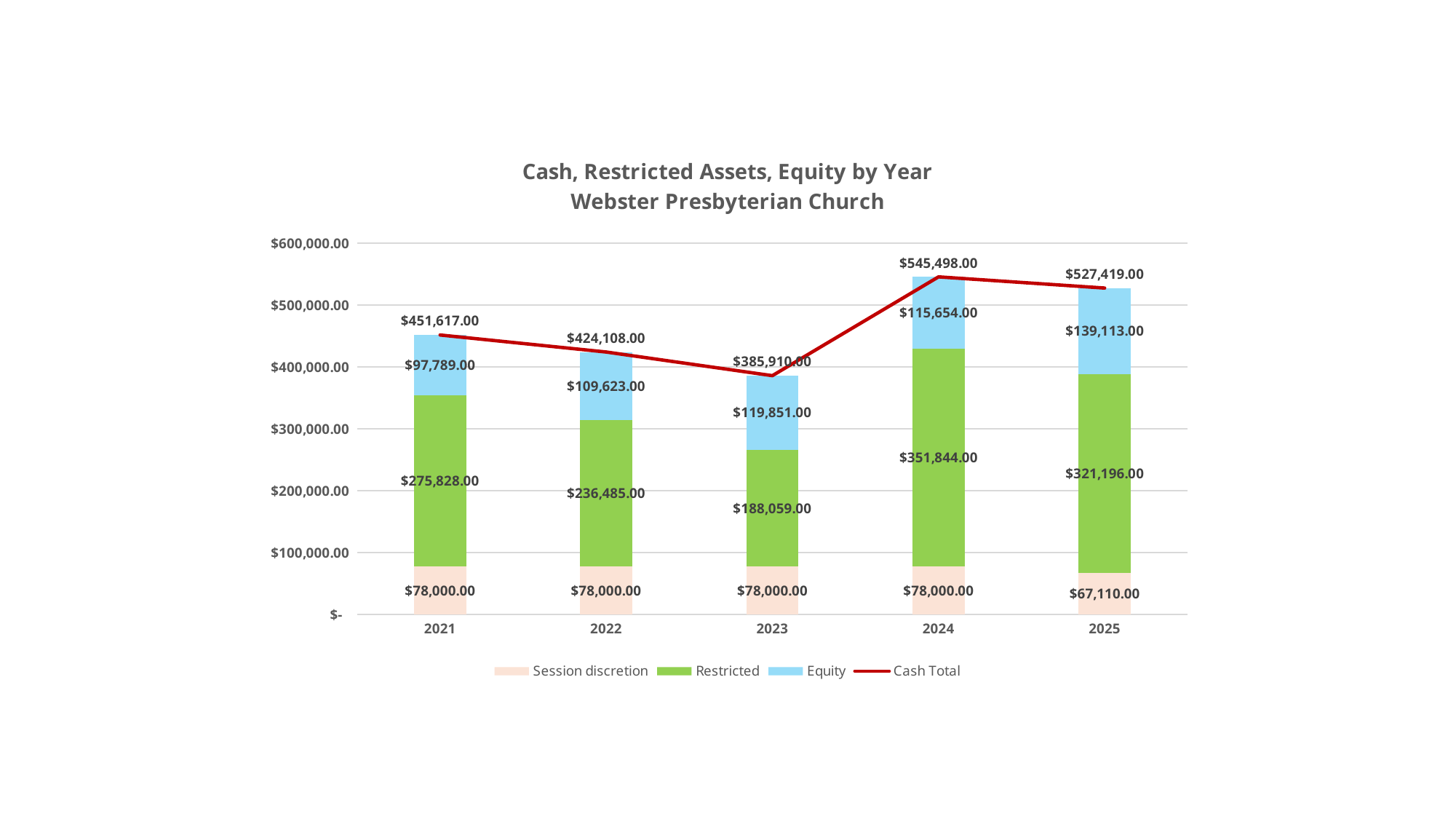
What is the total of the stacked bar for 2022? $424,108.00 What is the Restricted value for 2024? $351,844.00 How many years are shown on the x axis? 5 Which is larger, the Equity value for 2021 or the Equity value for 2025? 2025 Which year has the highest Cash Total? 2024 What is the difference between the Cash Total for 2024 and the Cash Total for 2025? $18,079.00 What is the Session discretion value for 2025? $67,110.00 Which year has the lowest Restricted value? 2023 What is the Cash Total for 2023? $385,910.00 How many series does the legend list? 4 What is the Equity value for 2022? $109,623.00 What kind of chart is this? Stacked bar chart with a line